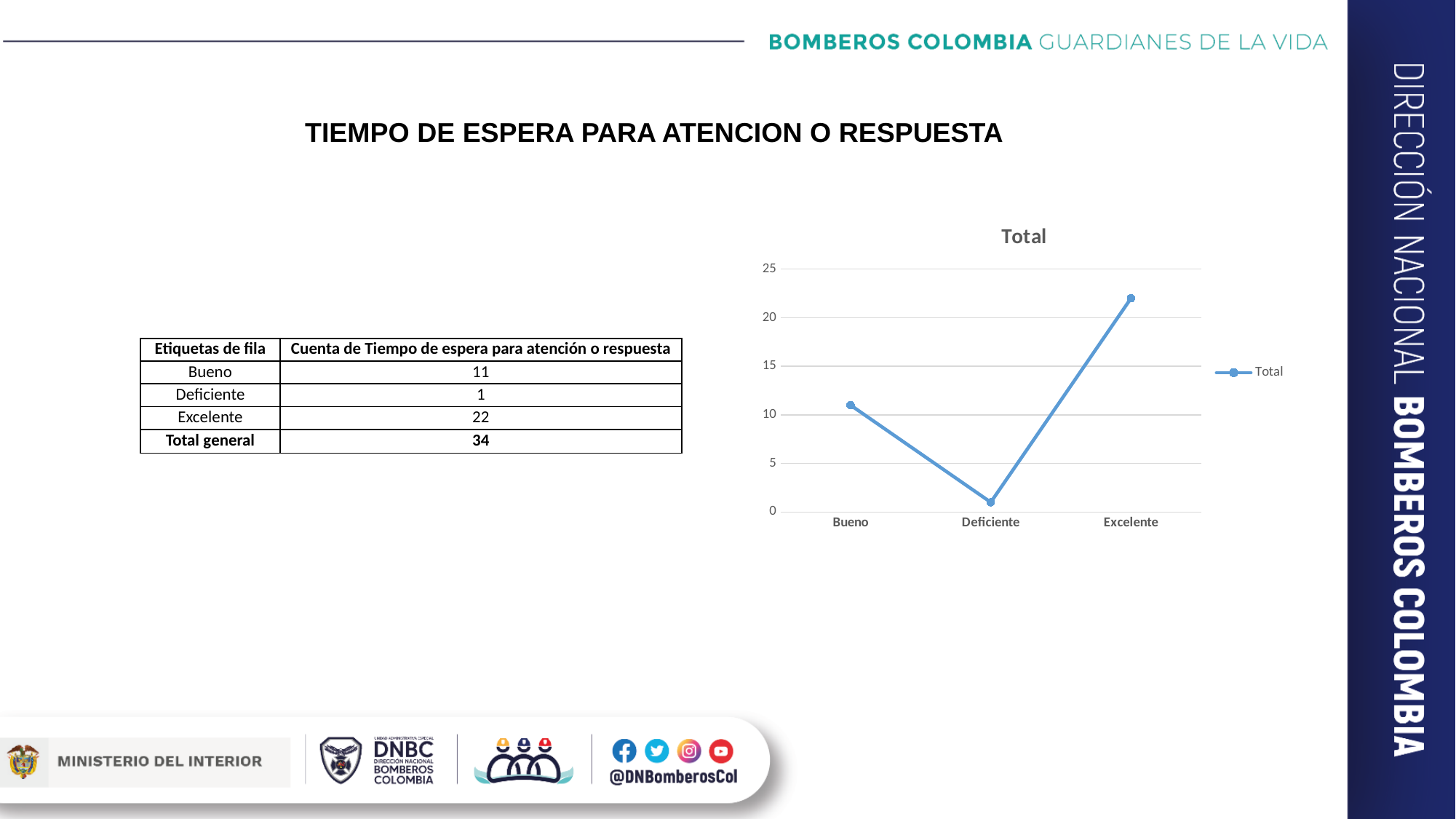
Which category has the lowest value in the chart? Deficiente Which category has the highest value in the chart? Excelente Is the value for Deficiente greater or less than 5? less What is the title of the chart? Total Is the value for Excelente greater or less than 20? greater Which is larger, the value for Bueno or the value for Excelente? Excelente According to the table on the slide, what is the count for Excelente? 22 How many series does the chart legend list? 1 What type of chart is shown on the slide? line chart According to the table on the slide, what is the difference between the counts for Excelente and Bueno? 11 How many categories are plotted on the x axis of the chart? 3 Is the value for Bueno greater or less than 15? less